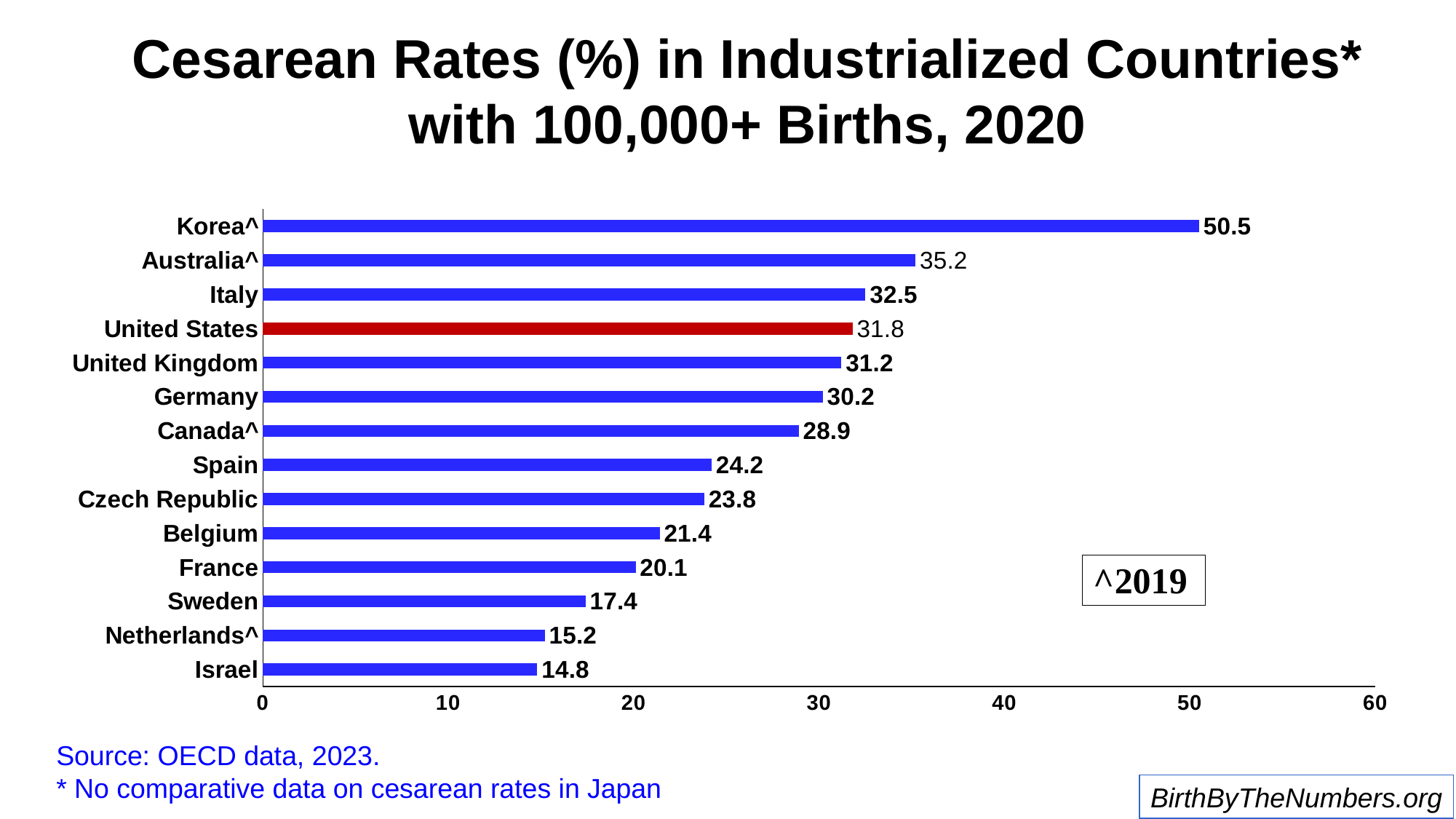
Which country has the lowest cesarean rate? Israel What is the cesarean rate for Sweden? 17.4 Which country has the highest cesarean rate? Korea^ What is the difference between the cesarean rates of Korea^ and Australia^? 15.3 What is the difference between the cesarean rates of Italy and the United States? 0.7 What is the cesarean rate for Germany? 30.2 Which has a higher cesarean rate, Spain or Belgium? Spain Which country's bar is colored red instead of blue? United States What kind of chart is shown on the slide? bar chart How many countries are shown in the chart? 14 Is the value for Canada^ greater or less than 30? less What is the cesarean rate for the United States? 31.8